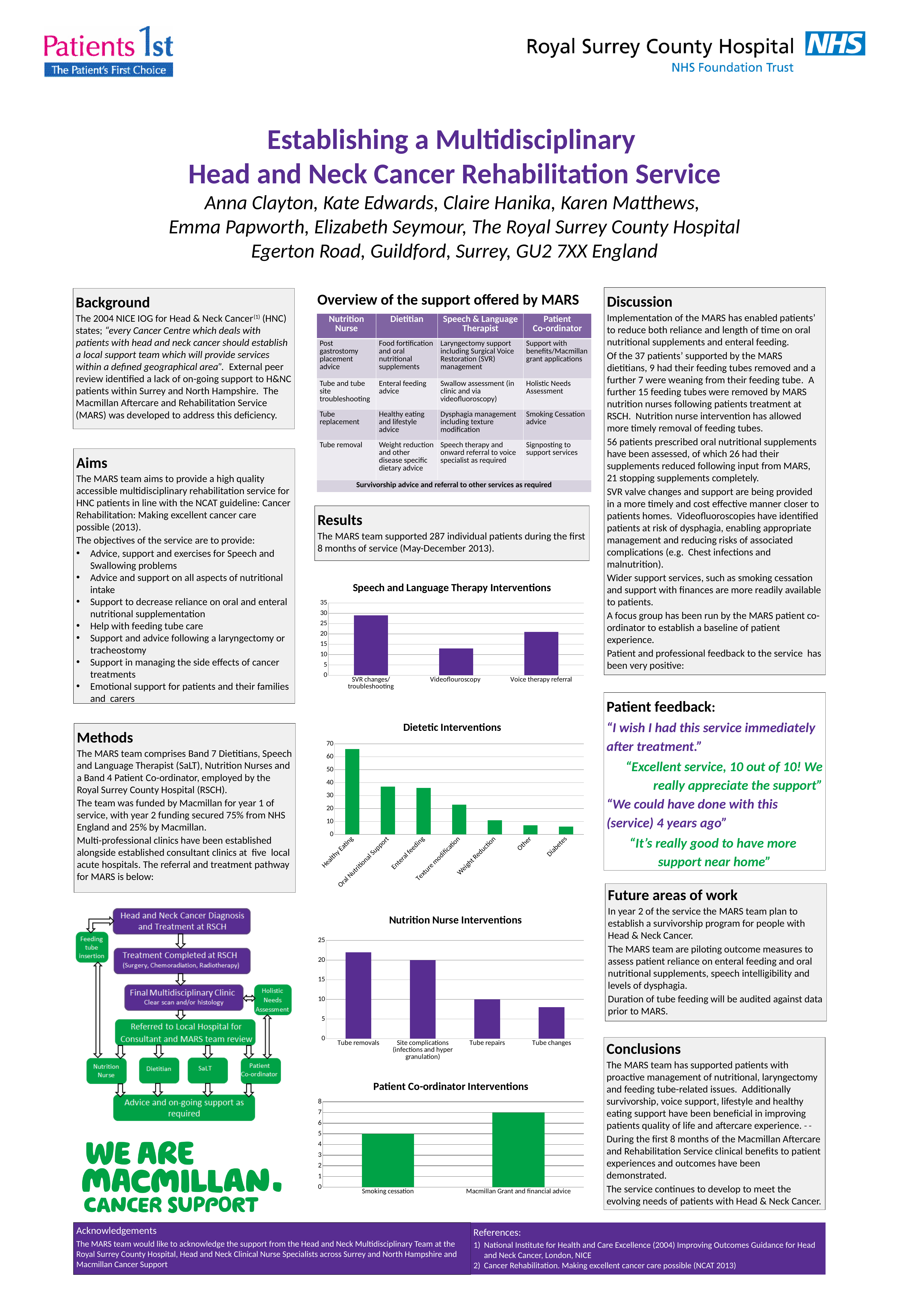
In the Speech and Language Therapy Interventions chart, which category has the lowest value? Videoflouroscopy In the Patient Co-ordinator Interventions chart, what is the value for Smoking cessation? 5 In the Speech and Language Therapy Interventions chart, is the value for SVR changes/troubleshooting greater or less than 25? greater In the Patient Co-ordinator Interventions chart, how many categories are shown? 2 In the Nutrition Nurse Interventions chart, which category has the lowest value? Tube changes In the Patient Co-ordinator Interventions chart, what is the value for Macmillan Grant and financial advice? 7 In the Dietetic Interventions chart, is the value for Texture modification greater or less than 20? greater In the Dietetic Interventions chart, how many categories are shown? 7 In the Nutrition Nurse Interventions chart, which category has the highest value? Tube removals In the Patient Co-ordinator Interventions chart, what is the difference between Macmillan Grant and financial advice and Smoking cessation? 2 In the Nutrition Nurse Interventions chart, what is the value for Tube repairs? 10 In the Dietetic Interventions chart, which category has the highest value? Healthy Eating